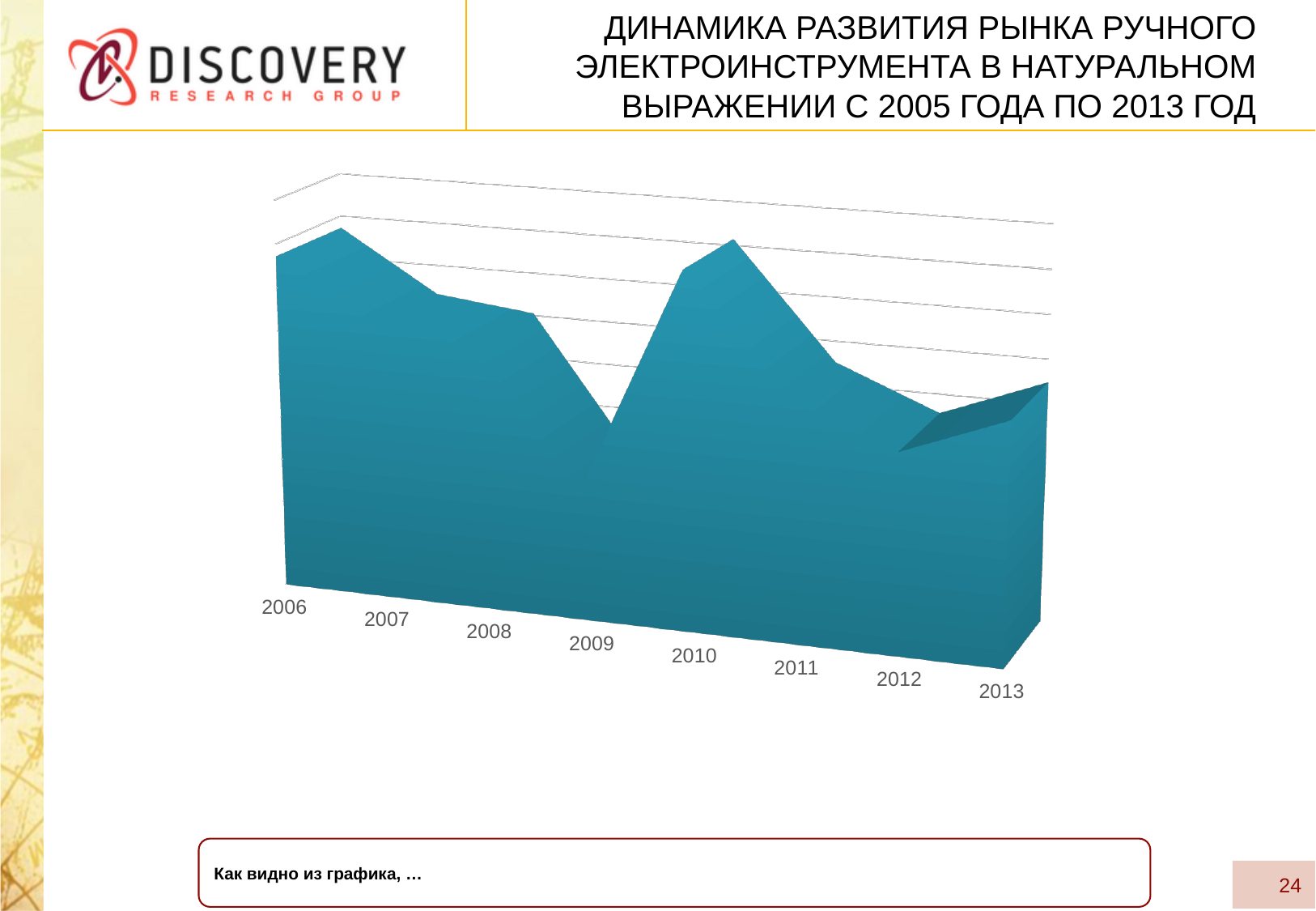
What kind of chart is shown on the slide? Area chart Does the value rise or fall from 2012 to 2013? Rise Which is larger, the value for 2008 or the value for 2009? 2008 How many years are labelled on the x axis of the chart? 8 Does the value rise or fall from 2010 to 2011? Fall Does the value rise or fall from 2009 to 2010? Rise Which is larger, the value for 2010 or the value for 2012? 2010 What is the first year labelled on the x axis of the chart? 2006 What is the last year labelled on the x axis of the chart? 2013 Which is larger, the value for 2006 or the value for 2009? 2006